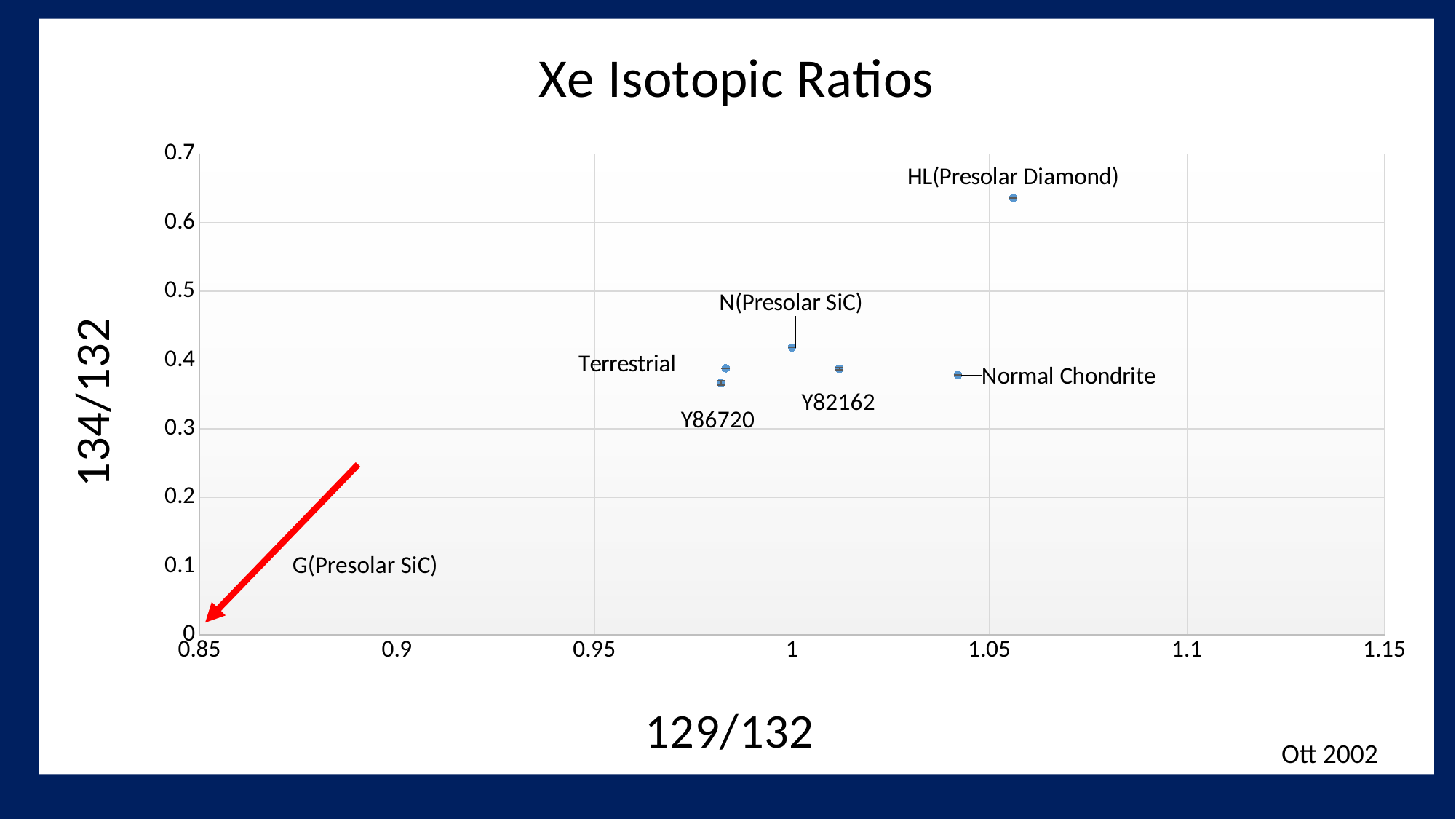
What is the label of the vertical axis? 134/132 Is the 134/132 value for HL(Presolar Diamond) greater or less than 0.6? greater Is the 134/132 value for N(Presolar SiC) greater or less than 0.4? greater Which has a higher 129/132 value, Normal Chondrite or Terrestrial? Normal Chondrite What is the title of the chart? Xe Isotopic Ratios Is the 129/132 value for Normal Chondrite greater or less than 1? greater Which has a higher 134/132 value, N(Presolar SiC) or Terrestrial? N(Presolar SiC) How many labelled data points are plotted on the chart (excluding the arrow for G(Presolar SiC))? 6 Which labelled point has the highest 134/132 value? HL(Presolar Diamond) What kind of chart is shown on the slide? scatter chart